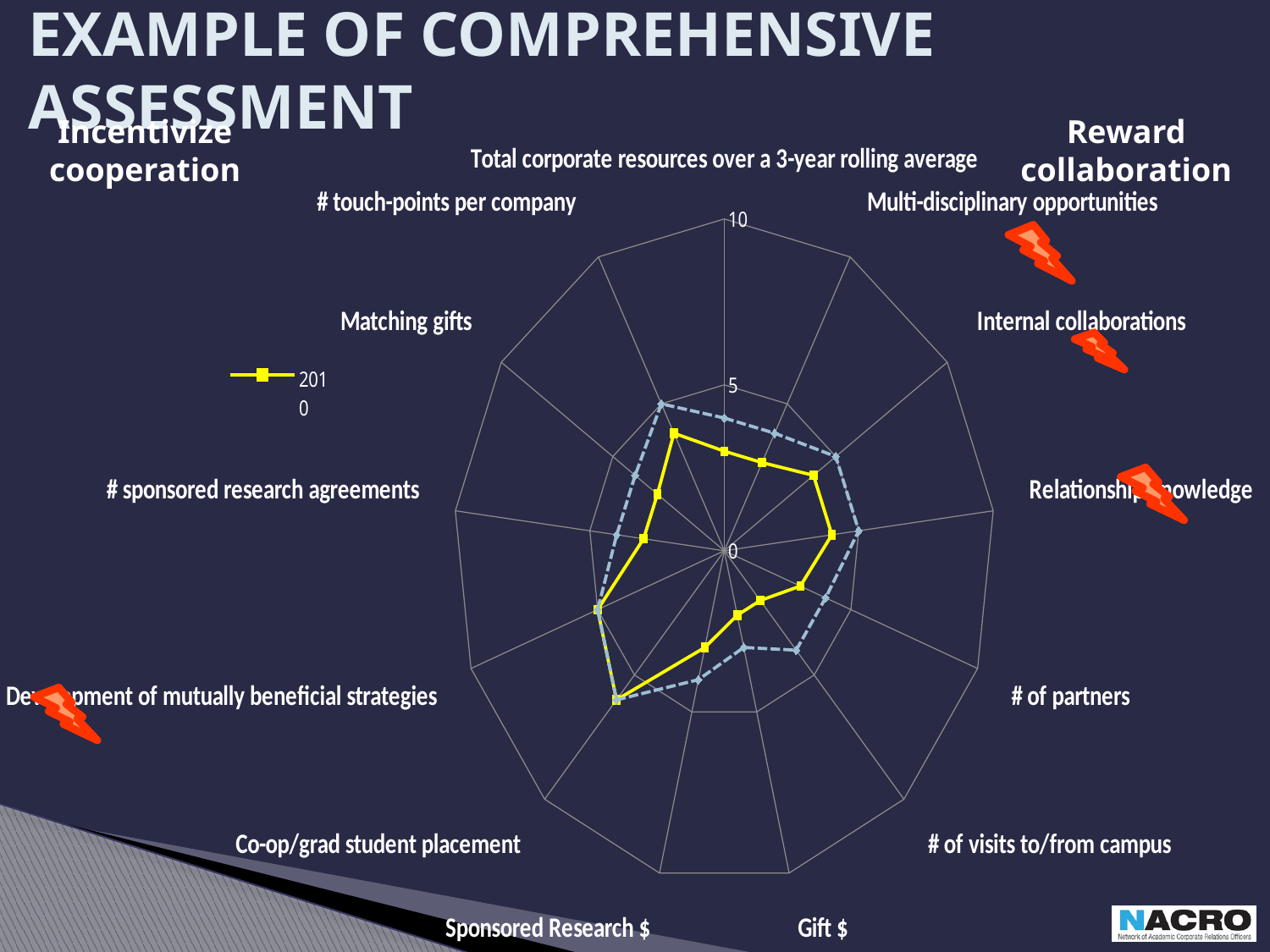
What is the highest value shown on the radar chart's axis scale? 10 Which category has the highest value for the yellow (solid) series? Co-op/grad student placement For the yellow series, which is larger: Sponsored Research $ or Gift $? Sponsored Research $ Is the yellow series value for Gift $ greater or less than 5? less How many categories (axes) does the radar chart have? 13 Is the yellow series value for # of partners greater or less than 5? less Is the yellow series value for Matching gifts greater or less than 5? less What kind of chart is shown on the slide? radar chart For the yellow series, which is larger: Development of mutually beneficial strategies or # of partners? Development of mutually beneficial strategies